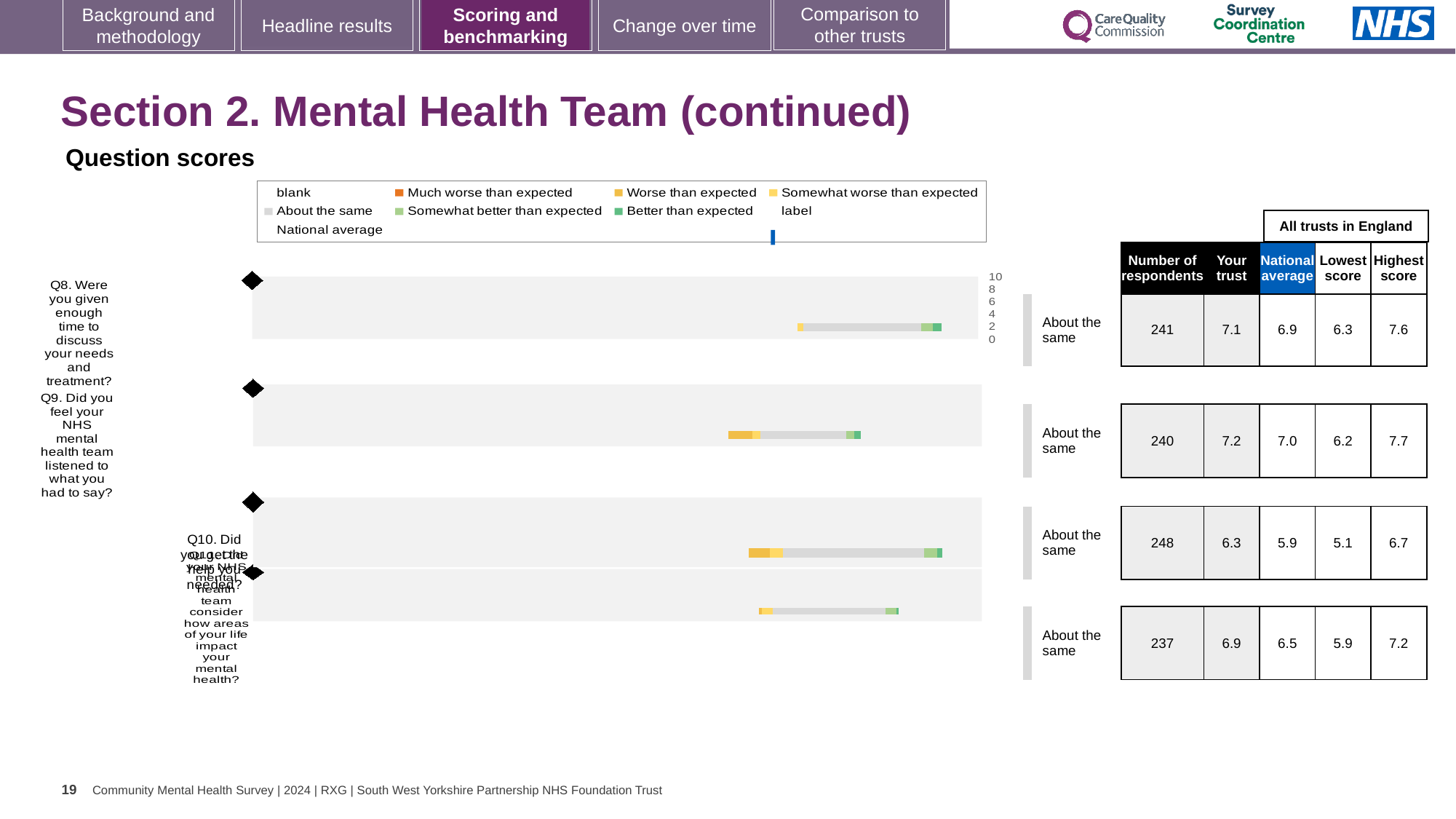
What benchmark category is shown next to the bar for Q11? About the same In the table beside the chart, what is the 'Your trust' score for Q8? 7.1 How many entries does the legend of the question scores chart list? 9 What colour does the legend use for 'Much worse than expected'? orange In the table beside the chart, which question has the highest 'Your trust' score? Q9 In the table beside the chart, what is the difference between the highest score and the lowest score for Q10? 1.6 What is the highest value shown on the score axis of the chart? 10 What kind of chart is used to show the question scores on this slide? bar chart How many questions (bars) are plotted in the question scores chart? 4 For Q8, which is larger in the table beside the chart: the 'Your trust' score or the national average? Your trust In the table beside the chart, how many respondents are listed for Q9? 240 In the table beside the chart, which question has the lowest national average score? Q10